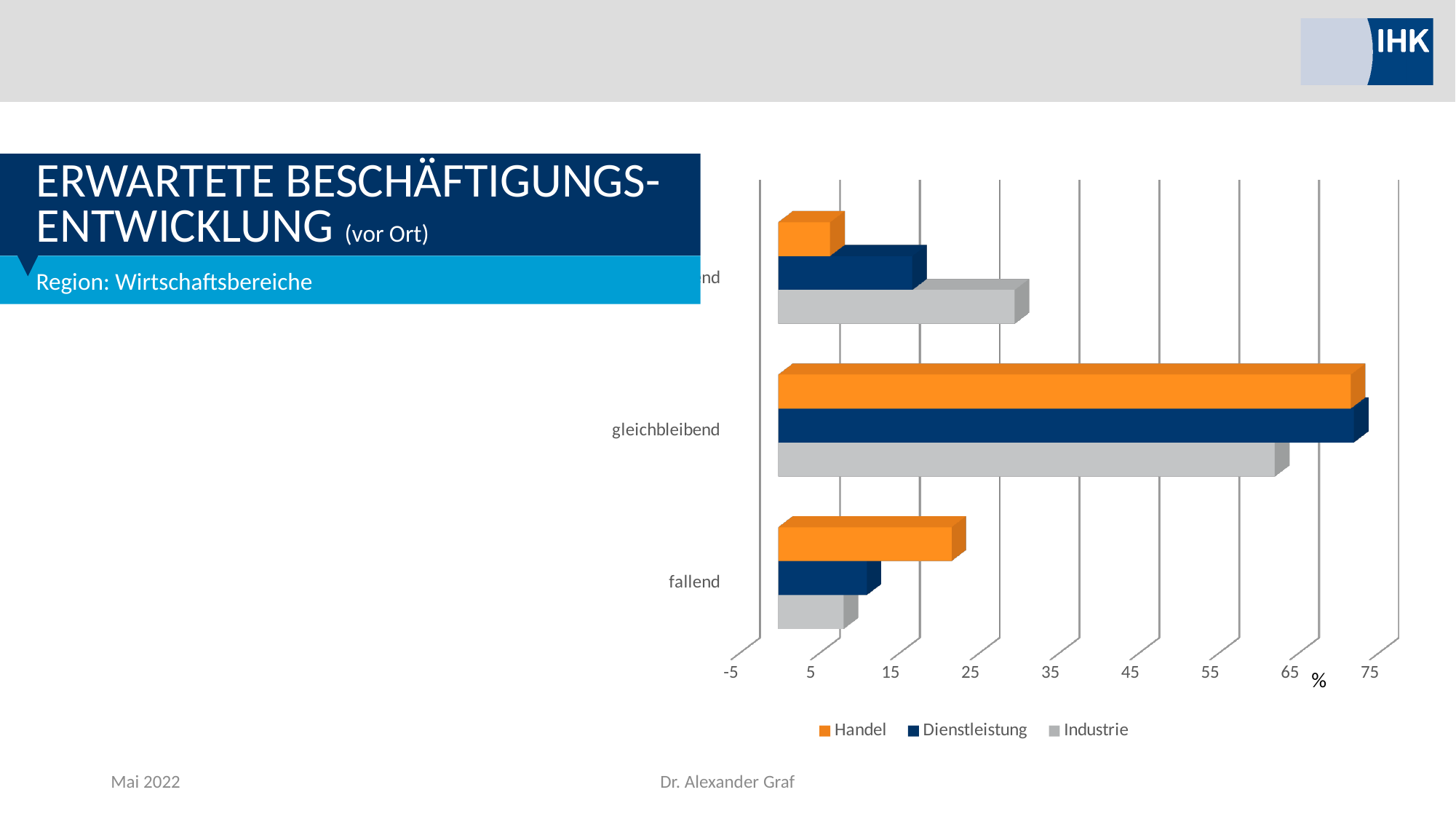
In the category fallend, which series has the lowest value? Industrie In the category fallend, which series has the highest value? Handel Is the value for Dienstleistung in the category fallend greater or less than 5? greater Is the value for Handel in the category fallend greater or less than 15? greater In the category gleichbleibend, which is larger: the value for Handel or the value for Industrie? Handel Is the value for Handel in the category gleichbleibend greater or less than 65? greater Which series are listed in the legend? Handel, Dienstleistung, Industrie How many categories are plotted on the vertical axis? 3 How many series does the legend list? 3 What kind of chart is shown on the slide? bar chart